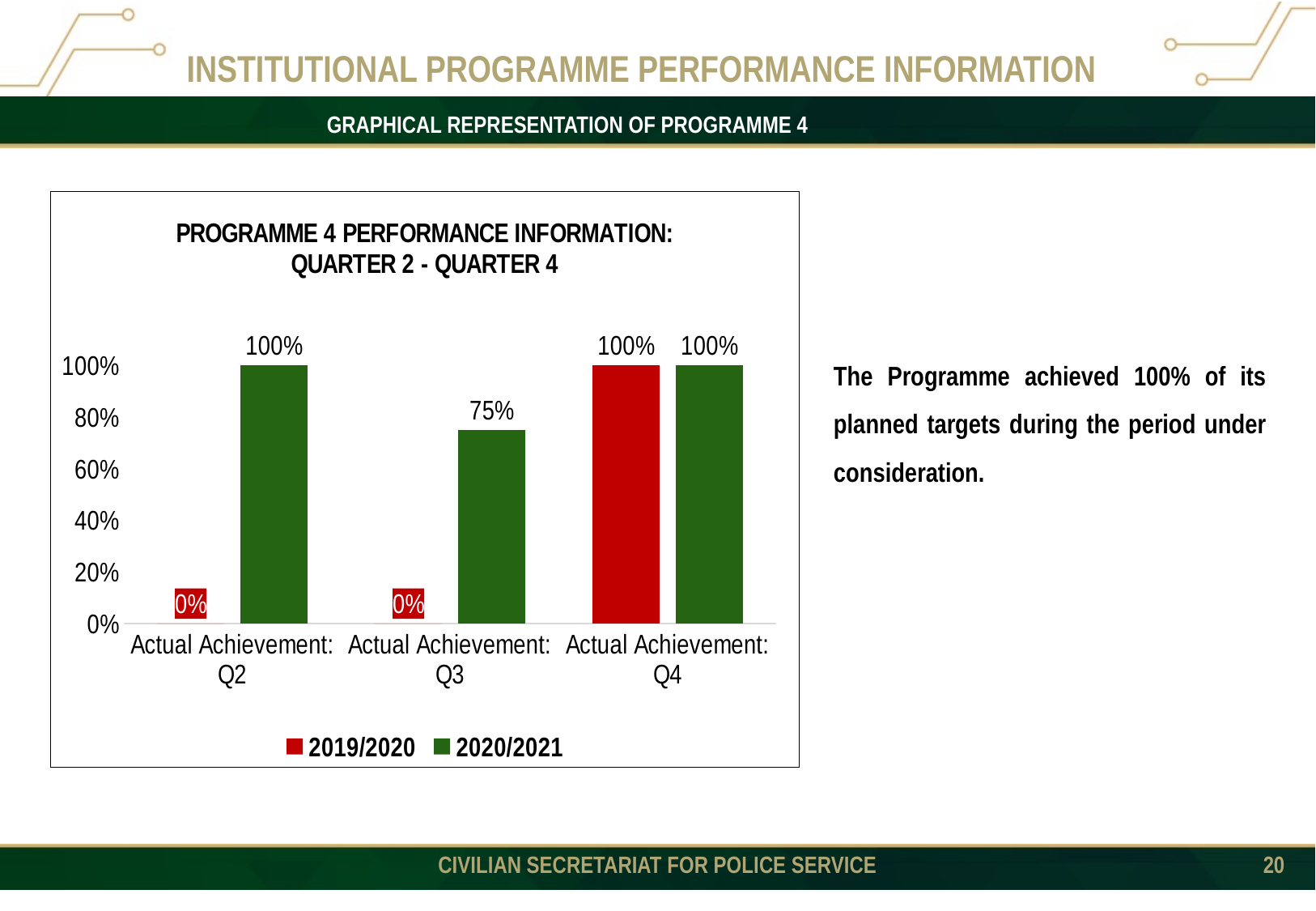
Which is larger for Actual Achievement: Q2, the 2019/2020 value or the 2020/2021 value? 2020/2021 What is the 2020/2021 value for Actual Achievement: Q2? 100% What is the 2019/2020 value for Actual Achievement: Q4? 100% What kind of chart is shown on the slide? Bar chart Which category has the lowest 2020/2021 value? Actual Achievement: Q3 What is the difference between the 2020/2021 values for Actual Achievement: Q2 and Actual Achievement: Q3? 25% What is the title of the chart? PROGRAMME 4 PERFORMANCE INFORMATION: QUARTER 2 - QUARTER 4 How many series does the legend list? 2 What is the difference between the 2020/2021 and 2019/2020 values for Actual Achievement: Q3? 75% What is the 2019/2020 value for Actual Achievement: Q2? 0% What is the 2020/2021 value for Actual Achievement: Q3? 75% How many categories are shown on the x axis? 3